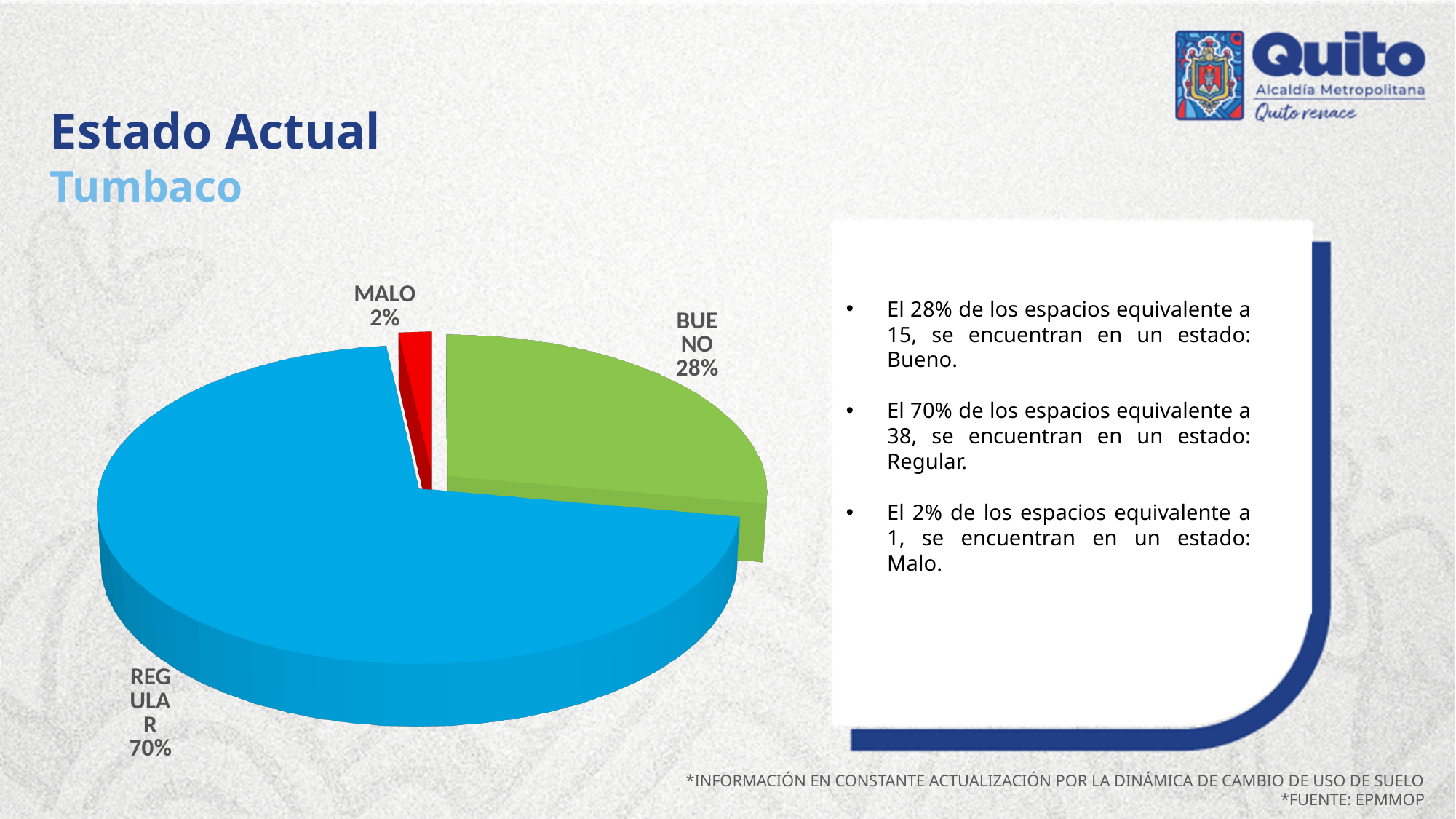
Which slice is larger, BUENO or MALO? BUENO What percentage of the pie is labelled MALO? 2% Which category has the smallest slice of the pie? MALO What colour is the REGULAR slice of the pie? blue What percentage of the pie is labelled REGULAR? 70% What kind of chart is shown on the slide? pie chart Which category has the largest slice of the pie? REGULAR What percentage of the pie is labelled BUENO? 28% What is the difference in percentage points between the REGULAR and BUENO slices? 42 How many slices does the pie chart have? 3 What is the difference in percentage points between the BUENO and MALO slices? 26 What colour is the MALO slice of the pie? red